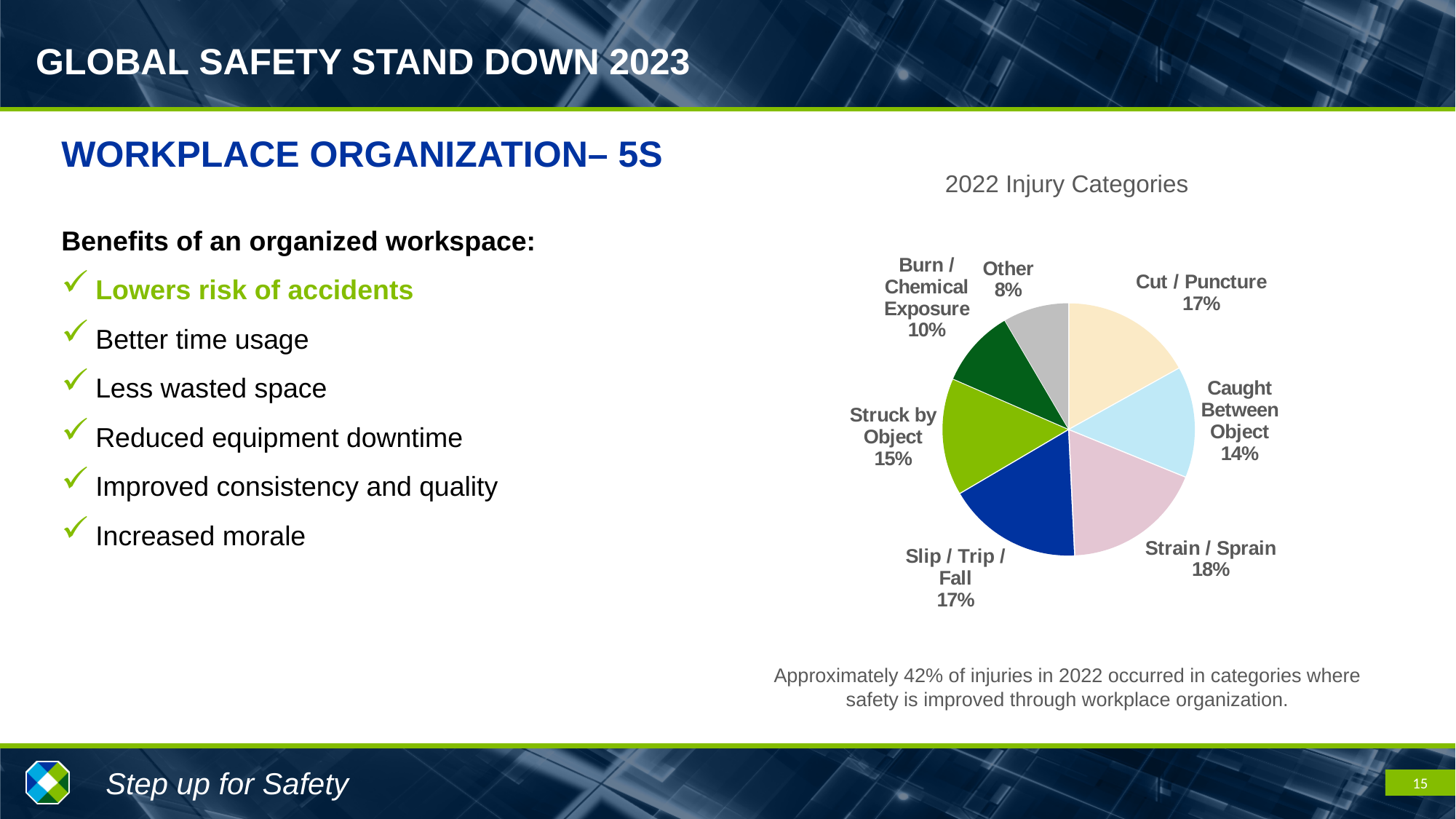
Which injury category has the smallest share? Other What is the difference in percentage points between Strain / Sprain and Caught Between Object? 4 What percentage is shown for Burn / Chemical Exposure? 10% What type of chart is shown on the slide? Pie chart How many injury categories are shown in the pie chart? 7 Which is larger, the share for Struck by Object or the share for Other? Struck by Object What share of the pie does Struck by Object represent? 15% Which injury category has the largest share? Strain / Sprain What is the title of the chart? 2022 Injury Categories What percentage is shown for Caught Between Object? 14% What percentage of injuries is attributed to Strain / Sprain? 18% What colour is the Slip / Trip / Fall slice? Dark blue